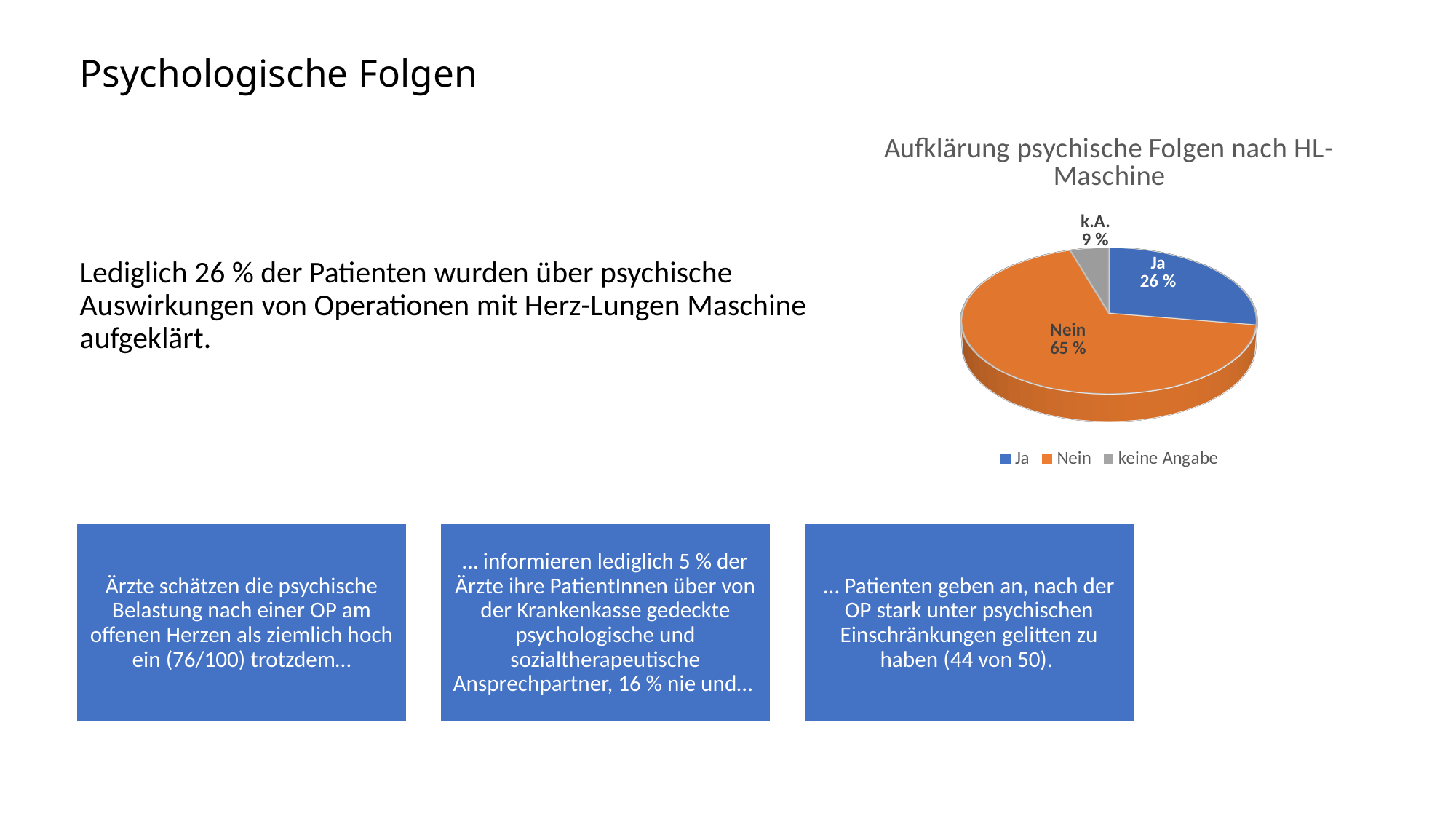
What kind of chart is shown on the slide? pie chart How many slices does the pie chart have? 3 What percentage is shown for the "Nein" slice? 65 % What percentage is shown for the "Ja" slice? 26 % What percentage is shown for the "k.A." slice? 9 % What is the title of the chart? Aufklärung psychische Folgen nach HL-Maschine Which is larger, the "Ja" slice or the "k.A." slice? Ja Which slice of the pie is the largest? Nein What colour is the "Nein" slice? orange What is the difference in percentage points between the "Nein" and "Ja" slices? 39 Which slice of the pie is the smallest? k.A. How many entries does the legend list? 3